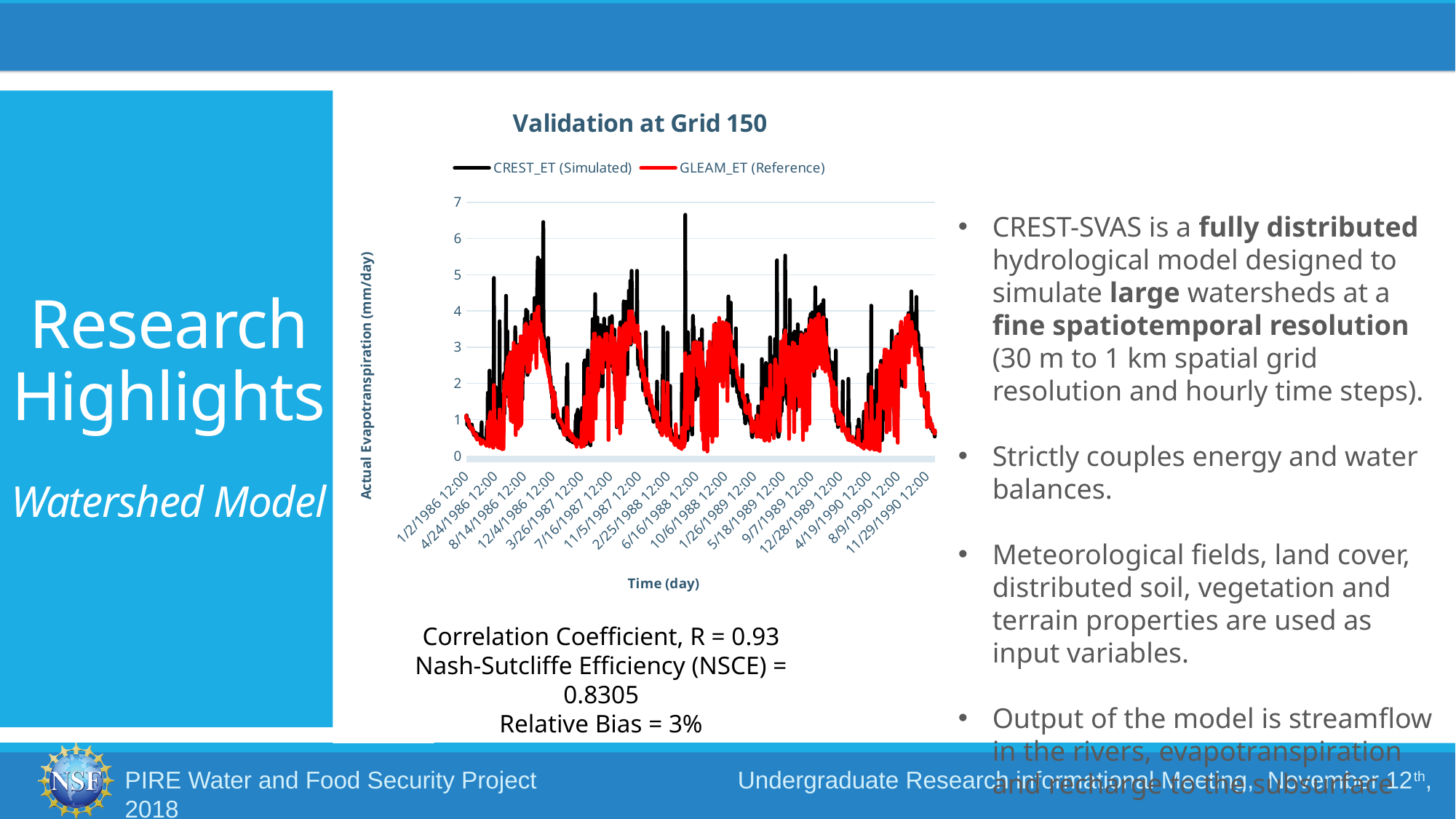
How many series does the legend of the "Validation at Grid 150" chart list? 2 In the "Validation at Grid 150" chart, is the highest value of the CREST_ET (Simulated) series greater or less than 6? greater What is the first date label on the x-axis of the "Validation at Grid 150" chart? 1/2/1986 12:00 What is the y-axis title of the "Validation at Grid 150" chart? Actual Evapotranspiration (mm/day) In the "Validation at Grid 150" chart, which series reaches the higher peak value, CREST_ET (Simulated) or GLEAM_ET (Reference)? CREST_ET (Simulated) In the "Validation at Grid 150" chart, is the highest value of the GLEAM_ET (Reference) series greater or less than 5? less In the "Validation at Grid 150" chart, is the highest value of the GLEAM_ET (Reference) series greater or less than 3? greater What is the title of the chart on the slide? Validation at Grid 150 What kind of chart is shown under the title "Validation at Grid 150"? line chart What is the highest tick value shown on the y-axis of the "Validation at Grid 150" chart? 7 What is the last date label on the x-axis of the "Validation at Grid 150" chart? 11/29/1990 12:00